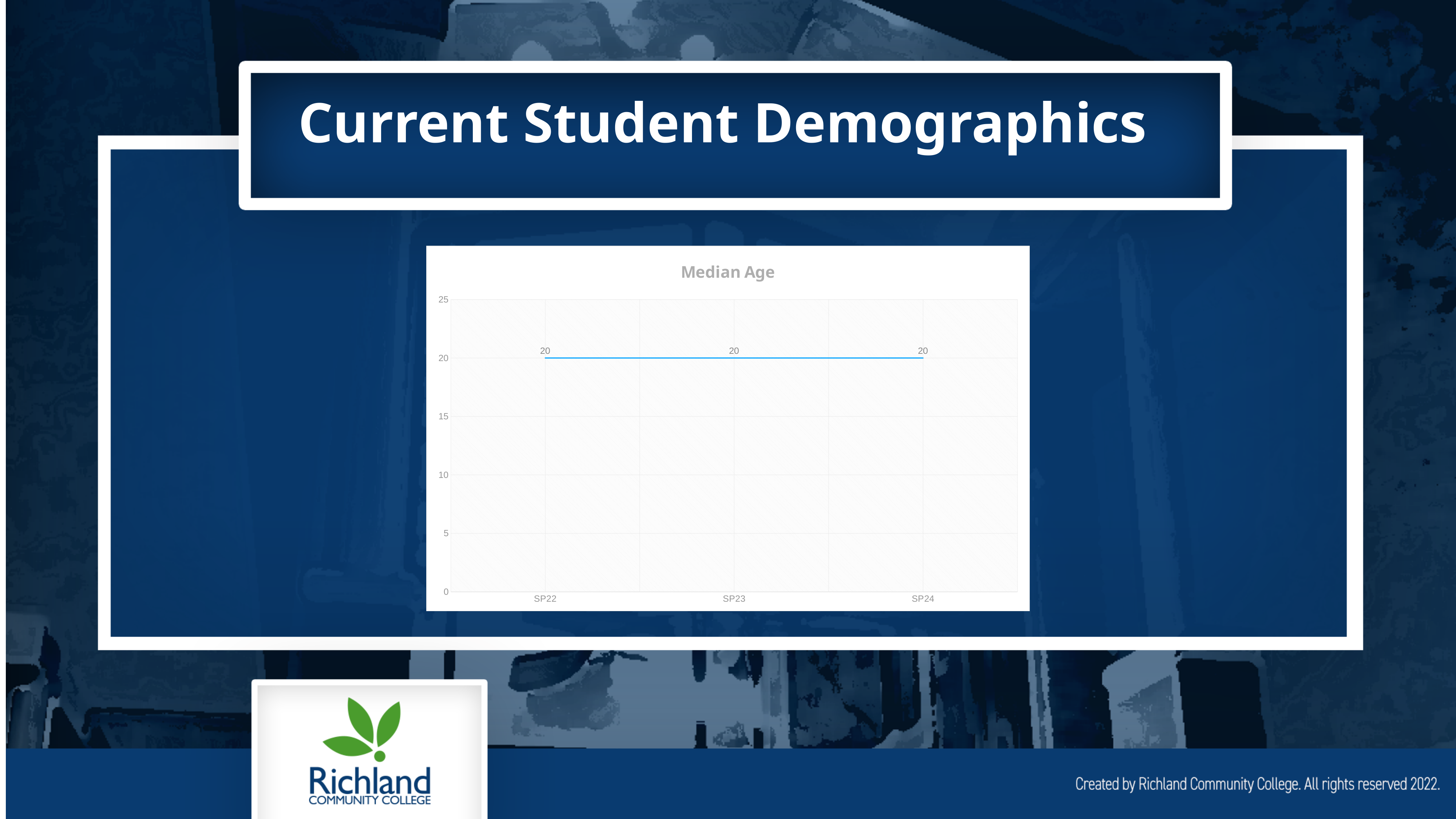
Does the median age rise, fall, or stay flat from SP22 to SP24? stays flat Is the median age for SP23 greater or less than 15? greater What is the median age for SP22? 20 What is the highest value shown on the y axis? 25 What is the median age for SP24? 20 Is the median age for SP22 greater or less than 25? less How many terms are plotted on the x axis? 3 What is the title of the chart? Median Age What is the median age for SP23? 20 What is the difference between the median age for SP24 and SP22? 0 What kind of chart is shown on the slide? line chart